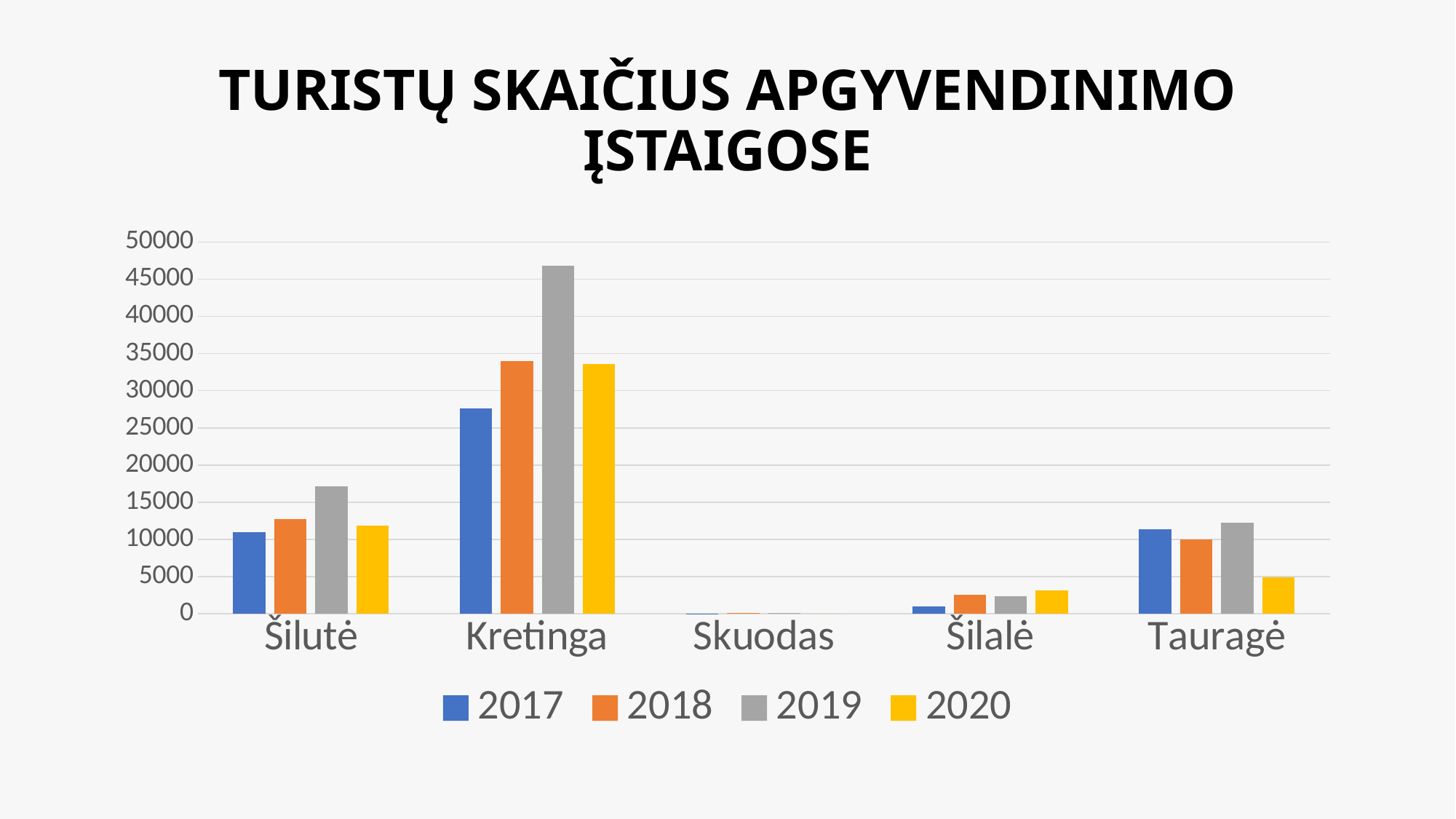
Is the value for Kretinga in 2019 greater or less than 45000? greater Which category has the lowest values across all years? Skuodas Is the value for Kretinga in 2017 greater or less than 25000? greater Which is larger, the 2019 value for Šilutė or the 2019 value for Tauragė? Šilutė Is the value for Šilutė in 2019 greater or less than 15000? greater Within Kretinga, which year has the tallest bar? 2019 How many series does the legend list? 4 What kind of chart is shown on the slide? bar chart What is the title of the chart? TURISTŲ SKAIČIUS APGYVENDINIMO ĮSTAIGOSE Which category has the highest value for 2019? Kretinga How many categories (municipalities) are shown on the x axis? 5